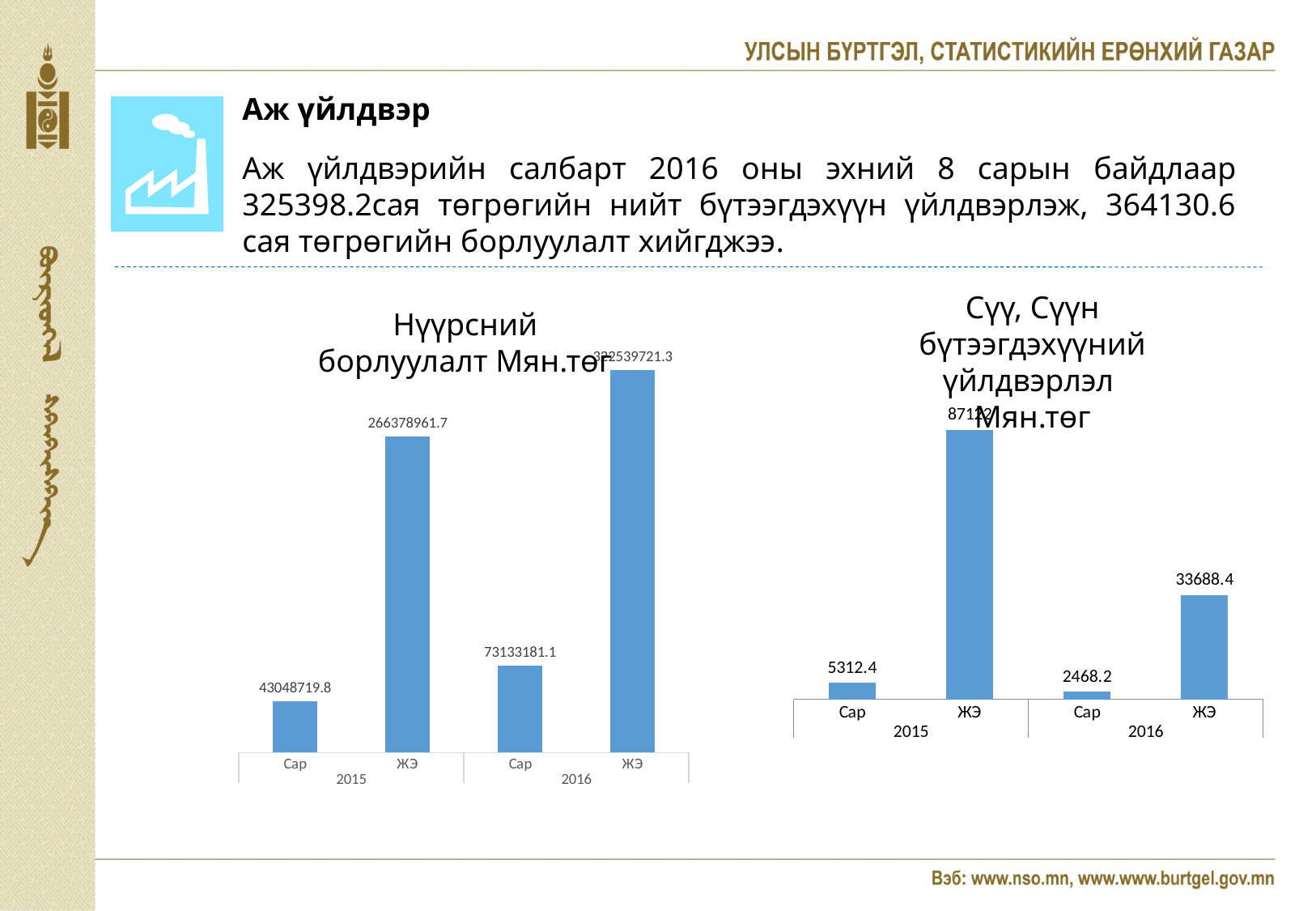
In the left chart (Нүүрсний борлуулалт Мян.төг), which bar is the lowest? Сар 2015 In the right chart (Сүү, Сүүн бүтээгдэхүүний үйлдвэрлэл Мян.төг), which is larger: Сар 2015 or Сар 2016? Сар 2015 In the right chart (Сүү, Сүүн бүтээгдэхүүний үйлдвэрлэл Мян.төг), how many bars are plotted? 4 In the left chart (Нүүрсний борлуулалт Мян.төг), what is the value for ЖЭ in 2015? 266378961.7 In the left chart (Нүүрсний борлуулалт Мян.төг), what is the value for Сар in 2015? 43048719.8 In the left chart (Нүүрсний борлуулалт Мян.төг), which bar is the highest? ЖЭ 2016 In the left chart (Нүүрсний борлуулалт Мян.төг), what is the difference between the Сар values for 2016 and 2015? 30084461.3 What type of chart is the left chart (Нүүрсний борлуулалт Мян.төг)? Bar chart In the right chart (Сүү, Сүүн бүтээгдэхүүний үйлдвэрлэл Мян.төг), what is the value for ЖЭ in 2016? 33688.4 In the right chart (Сүү, Сүүн бүтээгдэхүүний үйлдвэрлэл Мян.төг), what is the value for Сар in 2016? 2468.2 In the left chart (Нүүрсний борлуулалт Мян.төг), what is the value for Сар in 2016? 73133181.1 In the right chart (Сүү, Сүүн бүтээгдэхүүний үйлдвэрлэл Мян.төг), what is the value for Сар in 2015? 5312.4